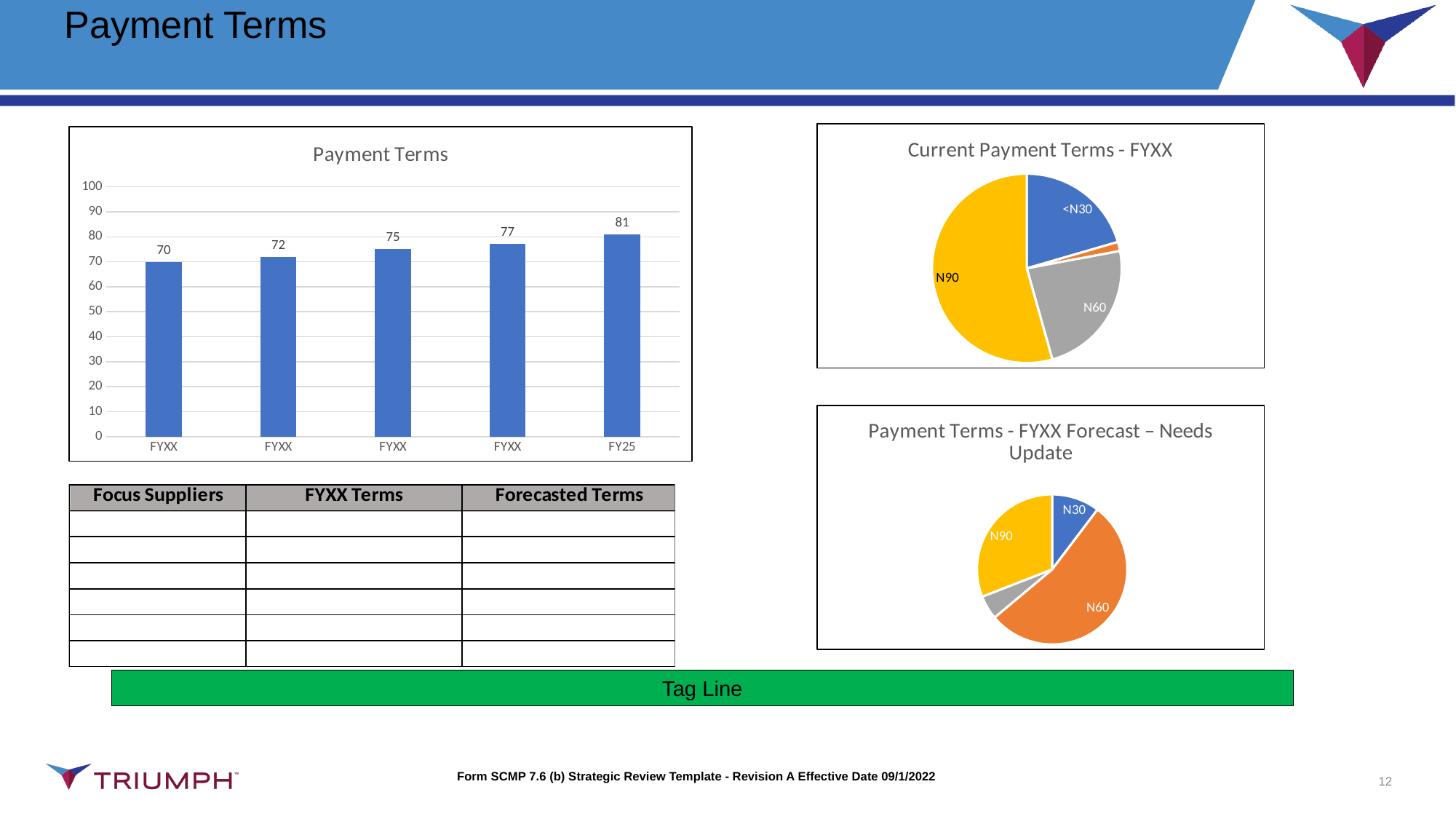
What kind of chart is 'Current Payment Terms - FYXX'? pie chart In the 'Current Payment Terms - FYXX' pie chart, which labeled slice is the largest? N90 In the 'Payment Terms' bar chart, which category has the highest value? FY25 In the 'Payment Terms' bar chart, what is the value for FY25? 81 In the 'Payment Terms' bar chart, what is the value of the third bar from the left? 75 In the 'Payment Terms' bar chart, do the values rise or fall from left to right? rise In the 'Payment Terms' bar chart, how many bars are plotted? 5 In the 'Payment Terms' bar chart, is the value for FY25 greater or less than 80? greater In the 'Payment Terms' bar chart, what is the value of the first (leftmost) bar? 70 What kind of chart is the 'Payment Terms' chart on the left of the slide? bar chart In the 'Payment Terms - FYXX Forecast – Needs Update' pie chart, which labeled slice is the largest? N60 In the 'Payment Terms' bar chart, what is the difference between the FY25 value and the first bar's value? 11